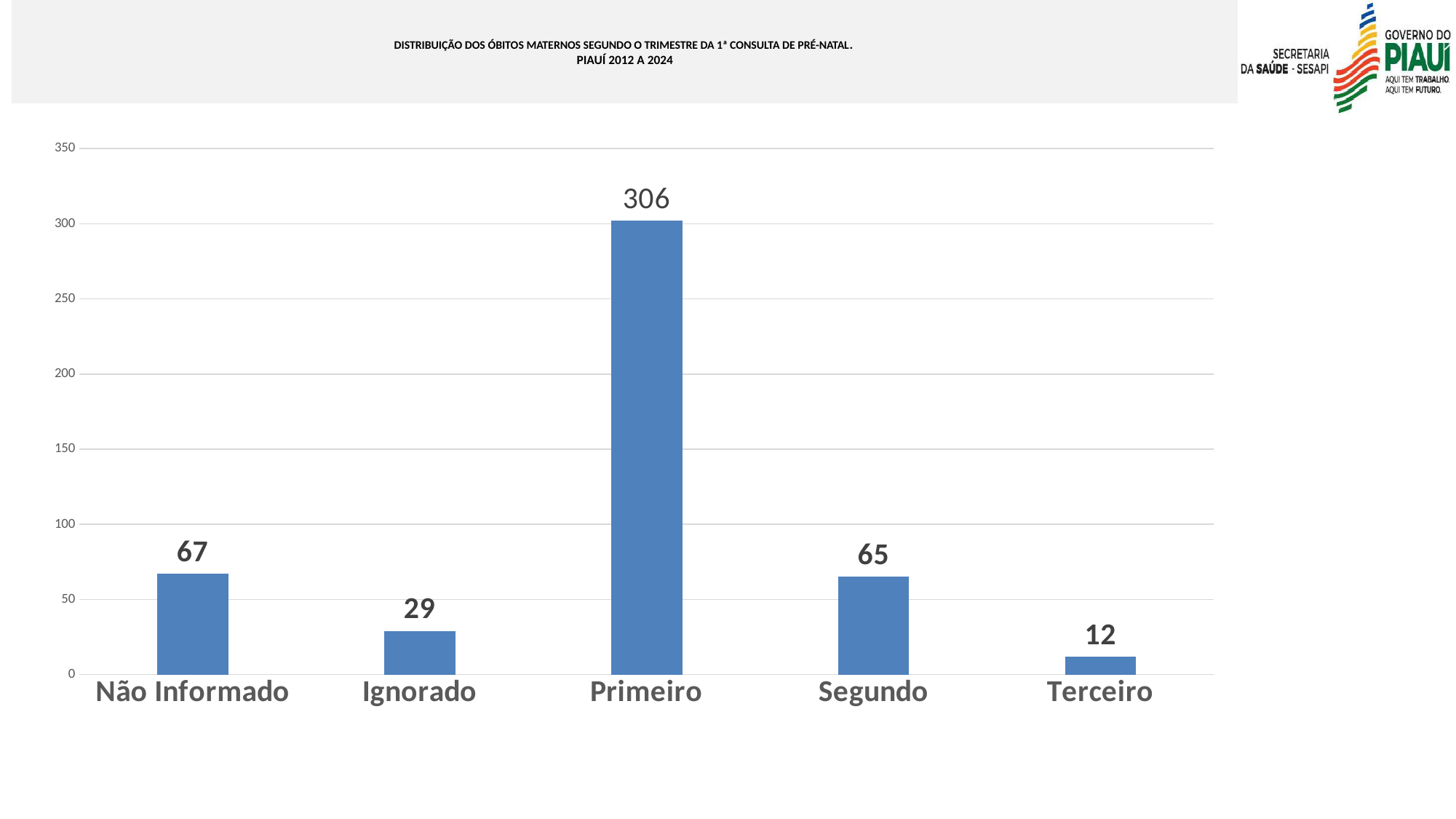
What is the difference between the values for Ignorado and Terceiro? 17 What is the value for Não Informado? 67 Is the value for Primeiro greater or less than 300? greater Which category has the highest value? Primeiro Which category has the lowest value? Terceiro What is the value for Primeiro? 306 What is the value for Terceiro? 12 Which is larger, the value for Ignorado or the value for Segundo? Segundo How many categories are shown on the x axis? 5 What kind of chart is shown on the slide? bar chart What period does the chart title say the data covers? 2012 a 2024 What is the difference between the values for Primeiro and Segundo? 241